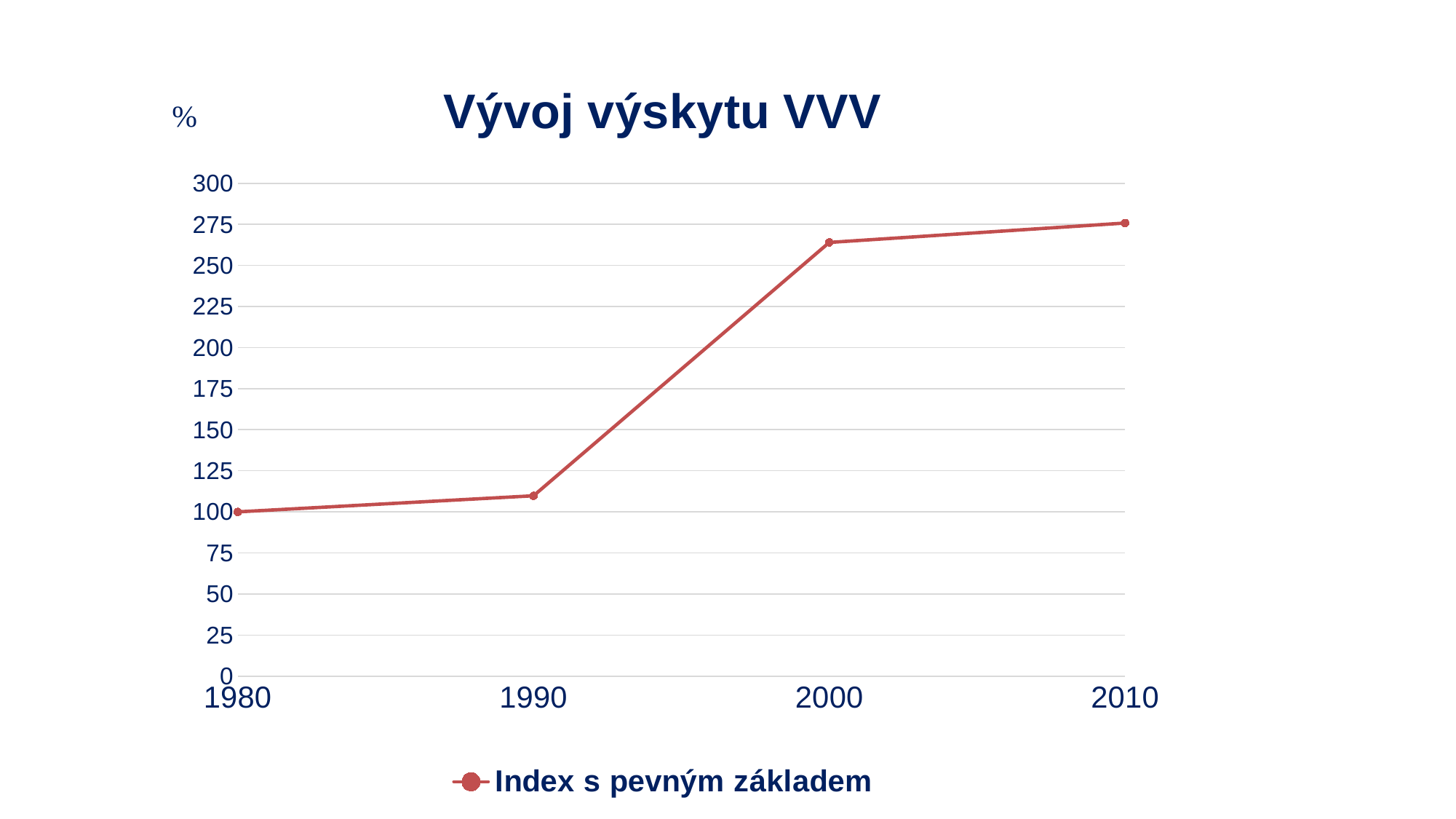
What is the name of the series shown in the legend? Index s pevným základem What is the title of the chart? Vývoj výskytu VVV How many data points are plotted on the line? 4 Which year has the highest value of the index? 2010 Do the values rise or fall from 1980 to 2010? rise Is the value for 2010 greater or less than 250? greater What kind of chart is shown on the slide? line chart Is the value for 1990 greater or less than 125? less What is the value of the index for 1980? 100 How many series does the legend list? 1 Which year has the lowest value of the index? 1980 Is the value for 2000 greater or less than 250? greater